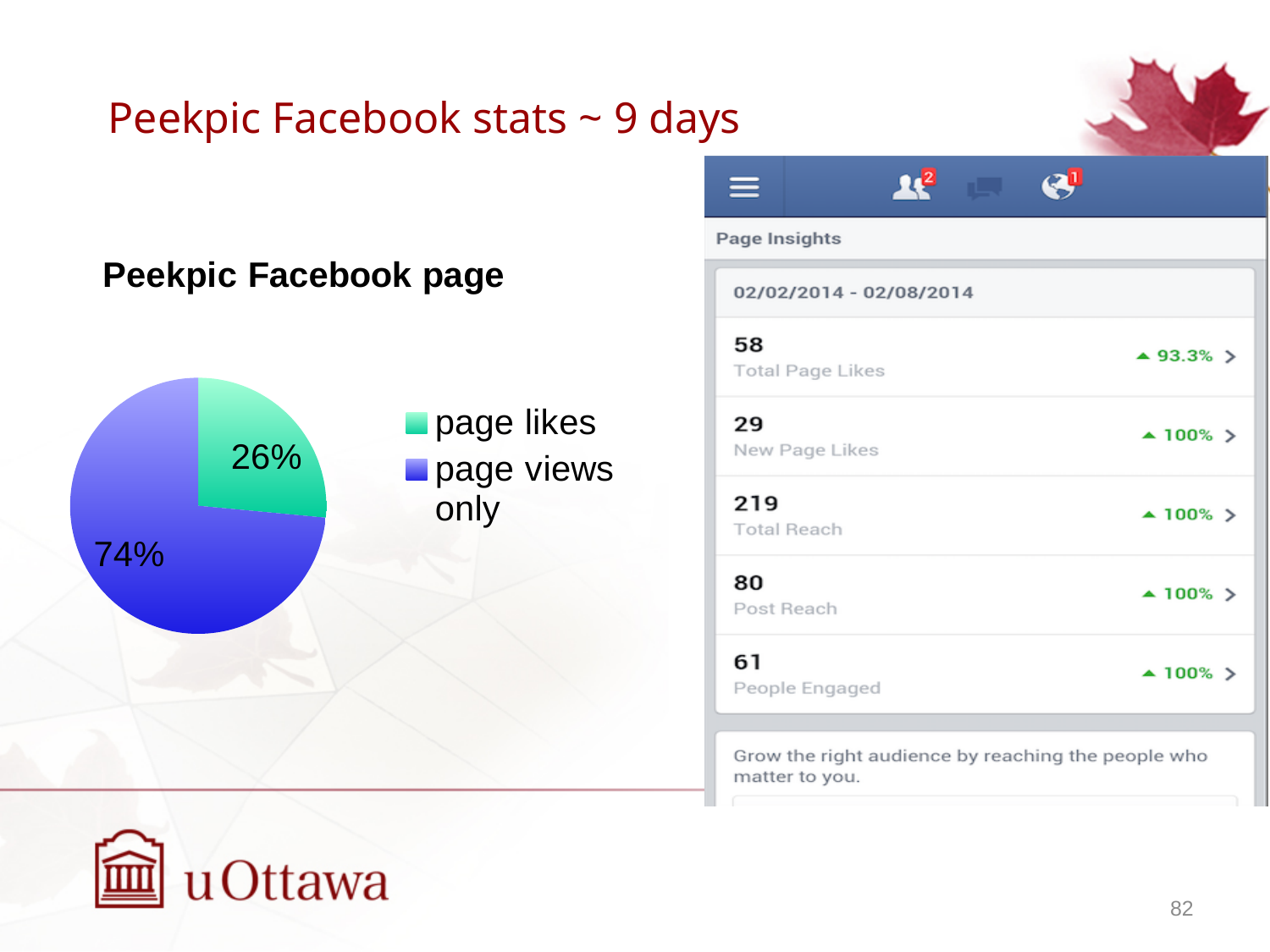
Is the share for "page likes" greater or less than 50%? less What colour is the "page views only" slice in the pie chart? blue How many entries does the pie chart's legend list? 2 Which slice of the pie chart is the smallest? page likes Which is larger, the "page likes" slice or the "page views only" slice? page views only What is the difference in percentage points between the "page views only" slice and the "page likes" slice? 48 What share of the pie does "page likes" represent? 26% What kind of chart is shown on the slide? pie chart Which slice of the pie chart is the largest? page views only What share of the pie does "page views only" represent? 74% What is the title shown above the pie chart? Peekpic Facebook page How many slices does the pie chart have? 2